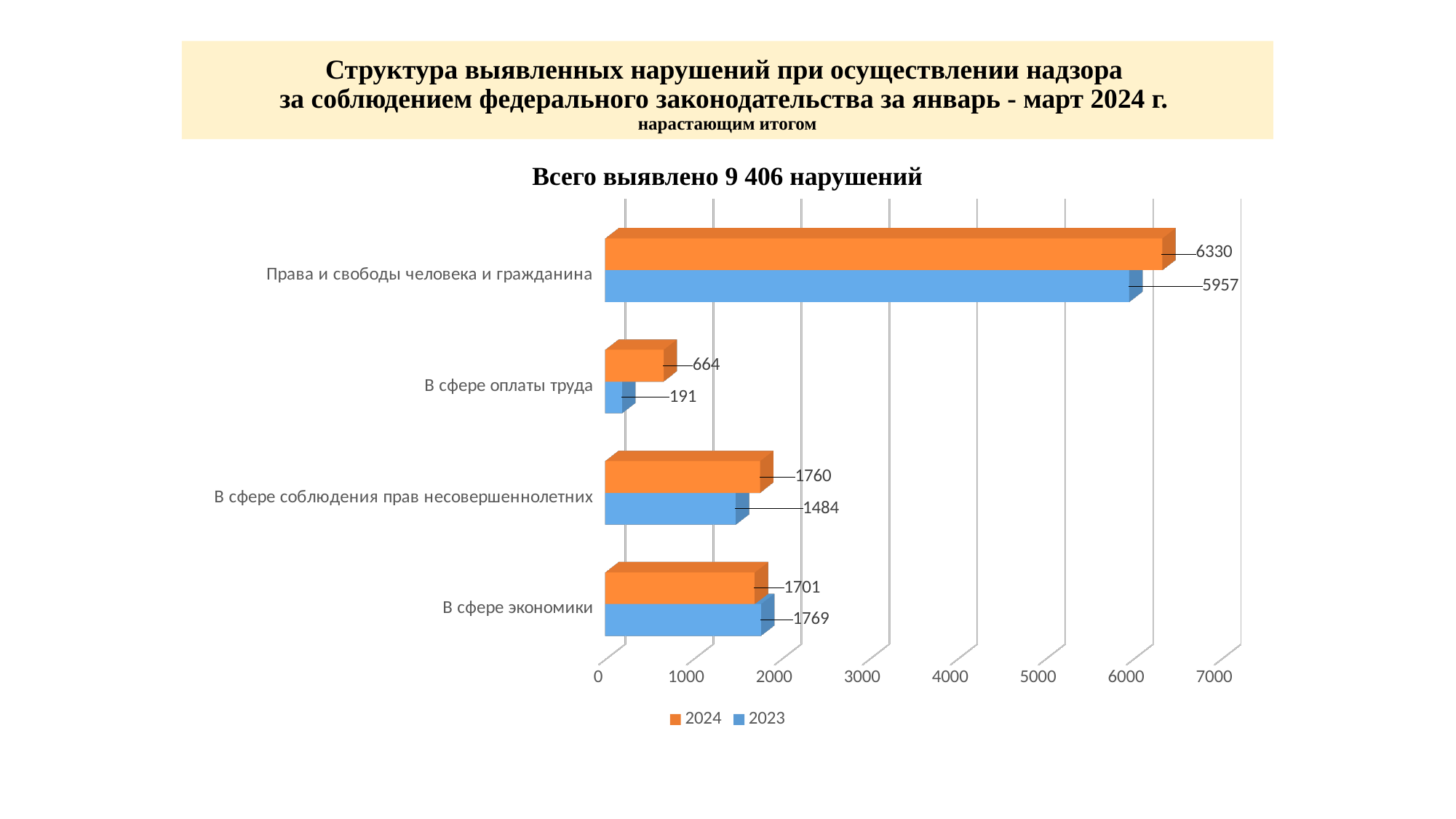
What is the difference between the 2024 and 2023 values for 'Права и свободы человека и гражданина'? 373 What is the 2023 value for 'В сфере экономики'? 1769 Which category has the highest 2024 value? Права и свободы человека и гражданина What is the 2024 value for 'В сфере соблюдения прав несовершеннолетних'? 1760 What is the difference between the 2024 and 2023 values for 'В сфере оплаты труда'? 473 Which category has the lowest 2023 value? В сфере оплаты труда What is the 2024 value for 'Права и свободы человека и гражданина'? 6330 What kind of chart is shown on the slide? Bar chart How many categories are shown on the chart? 4 What is the 2023 value for 'В сфере оплаты труда'? 191 How many series does the legend list? 2 For 'В сфере экономики', which year has the larger value, 2024 or 2023? 2023